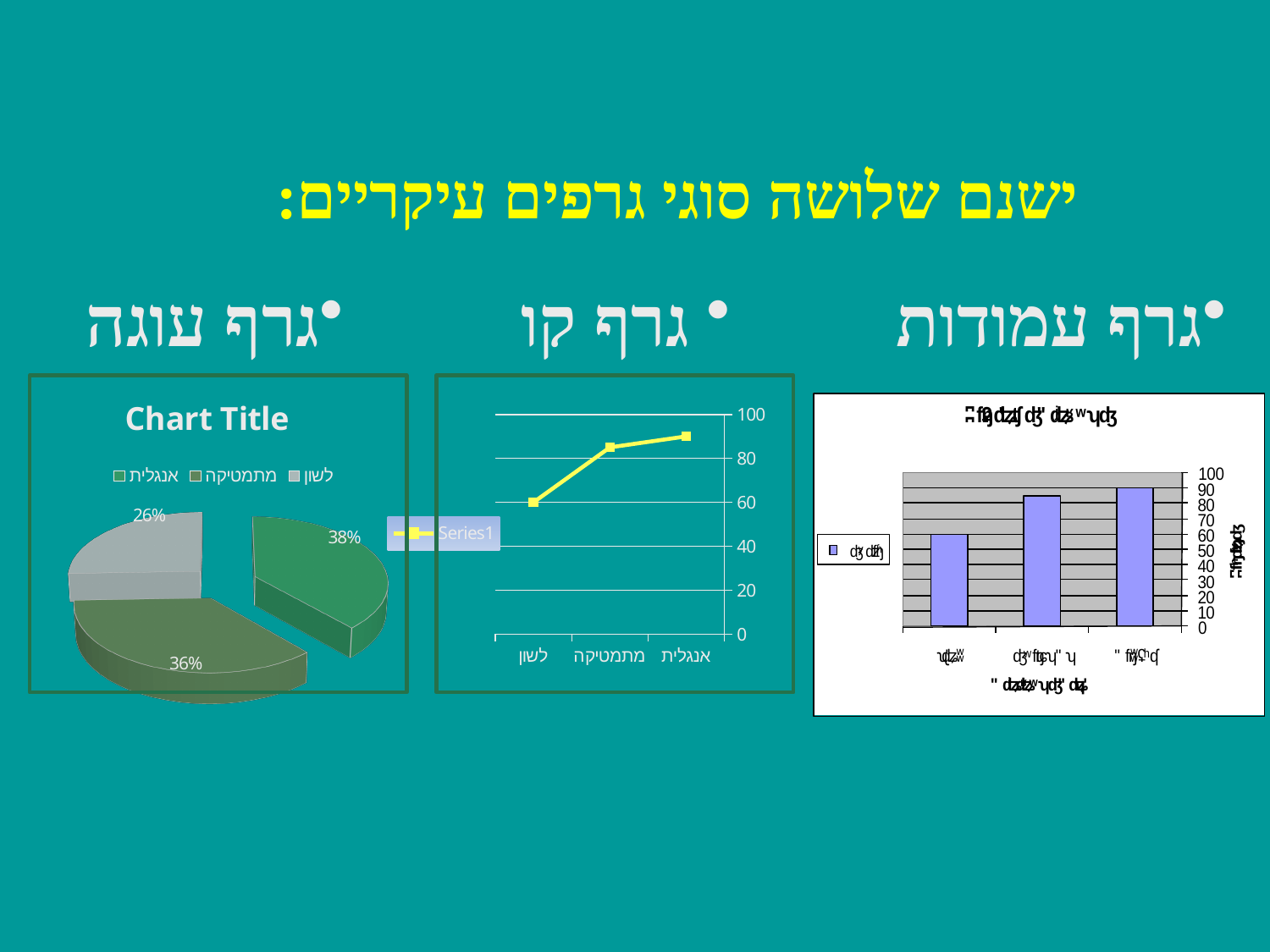
On the pie chart titled "Chart Title" on the left, which category has the smallest slice? לשון What kind of chart is the middle chart on the slide? line chart On the middle line chart, which category has the lowest value? לשון On the pie chart titled "Chart Title" on the left, what percentage is shown for לשון? 26% On the pie chart titled "Chart Title" on the left, what percentage is shown for אנגלית? 38% What kind of chart is the chart on the right of the slide, and how many bars does it have? bar chart, 3 bars On the middle line chart, what is the name of the series shown in the legend? Series1 On the pie chart titled "Chart Title" on the left, what percentage is shown for מתמטיקה? 36% On the middle line chart, is the value for אנגלית greater or less than 80? greater On the pie chart titled "Chart Title" on the left, what is the difference in percentage points between the אנגלית slice and the לשון slice? 12 On the pie chart titled "Chart Title" on the left, how many entries does the legend list? 3 On the middle line chart, is the value for לשון greater or less than 80? less